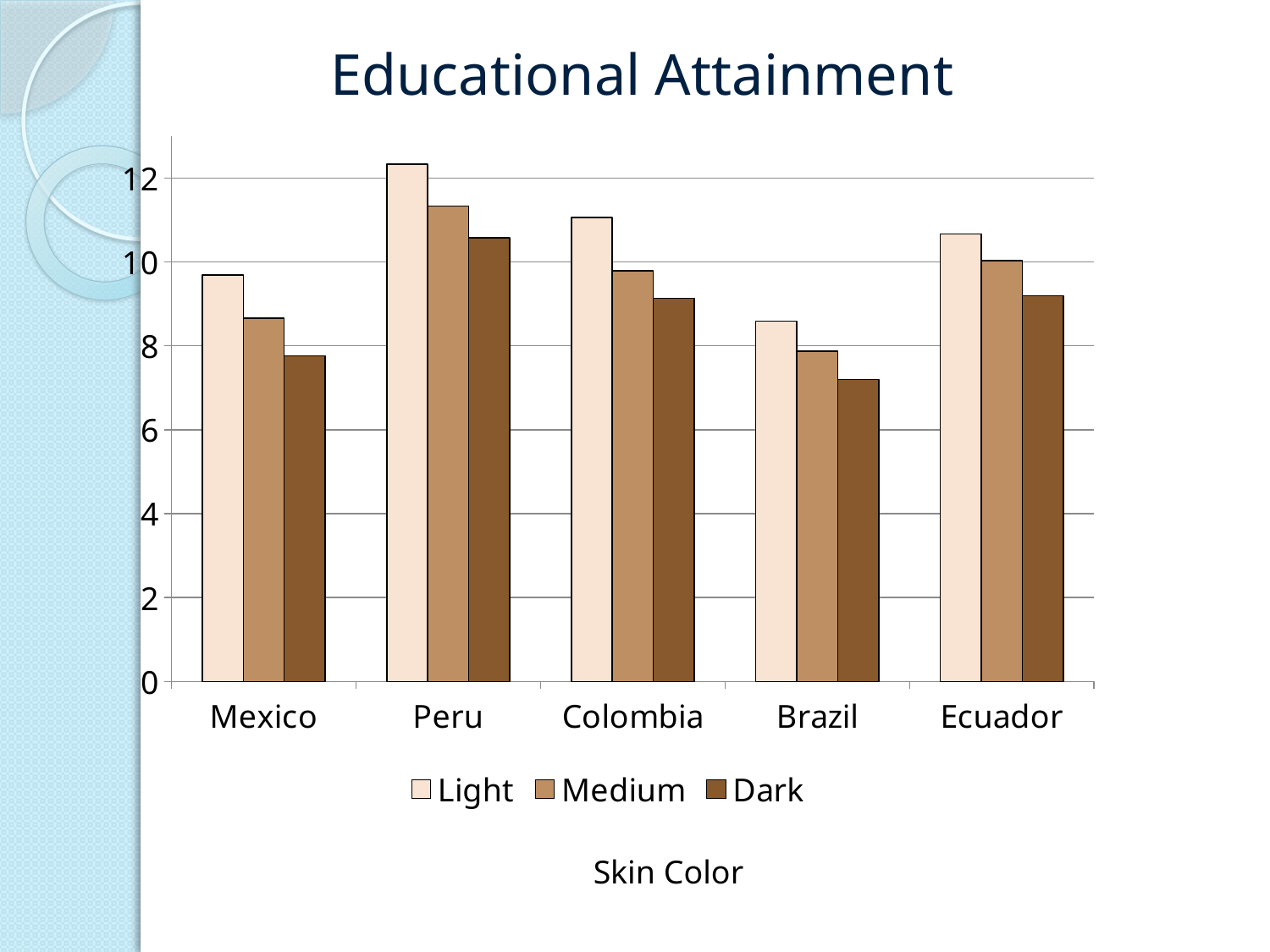
How many countries are shown on the x axis? 5 Which country has the lowest value for the Dark series? Brazil How many series does the legend list? 3 Which country has the highest value for the Light series? Peru Is the Dark value for Peru greater or less than 10? greater What kind of chart is shown on the slide? bar chart What is the title of the chart? Educational Attainment Is the Dark value for Brazil greater or less than 8? less What is the label shown below the legend on the x axis? Skin Color Is the Light value for Mexico greater or less than 10? less Which is larger, the Light value for Colombia or the Light value for Brazil? Colombia